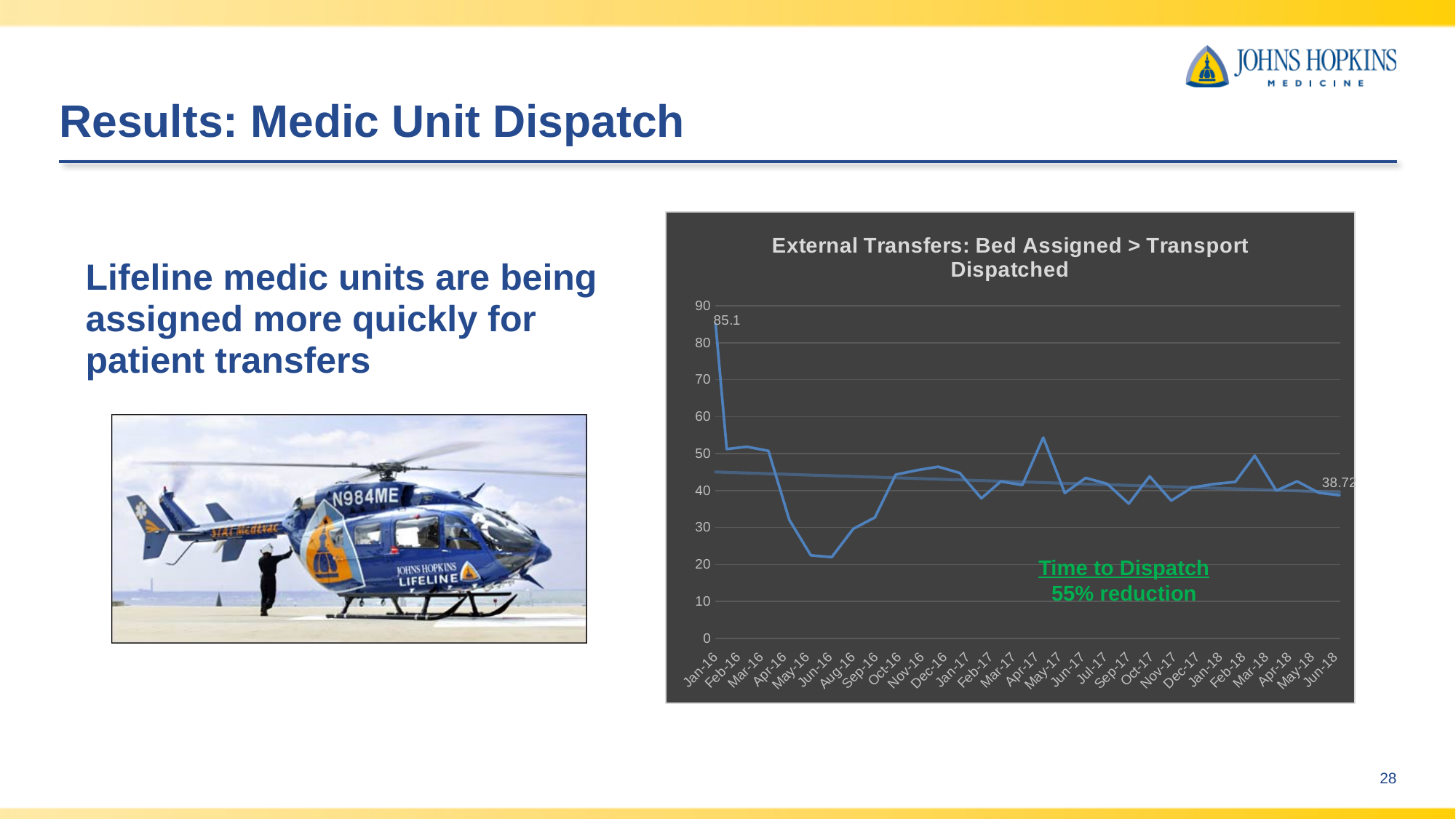
Is the value for Jun-16 greater or less than 30? less What is the title of the chart? External Transfers: Bed Assigned > Transport Dispatched What is the value for Jan-16? 85.1 What type of chart is shown on the slide? line chart What percentage reduction in time to dispatch is annotated on the chart? 55% reduction Is the value for Apr-17 greater or less than 50? less Which is larger, the value for Jan-16 or the value for Jun-18? Jan-16 Which month has the highest value? Jan-16 Is the value for Jan-16 greater or less than 80? greater Do the values generally rise or fall from Jan-16 to Jun-18? fall